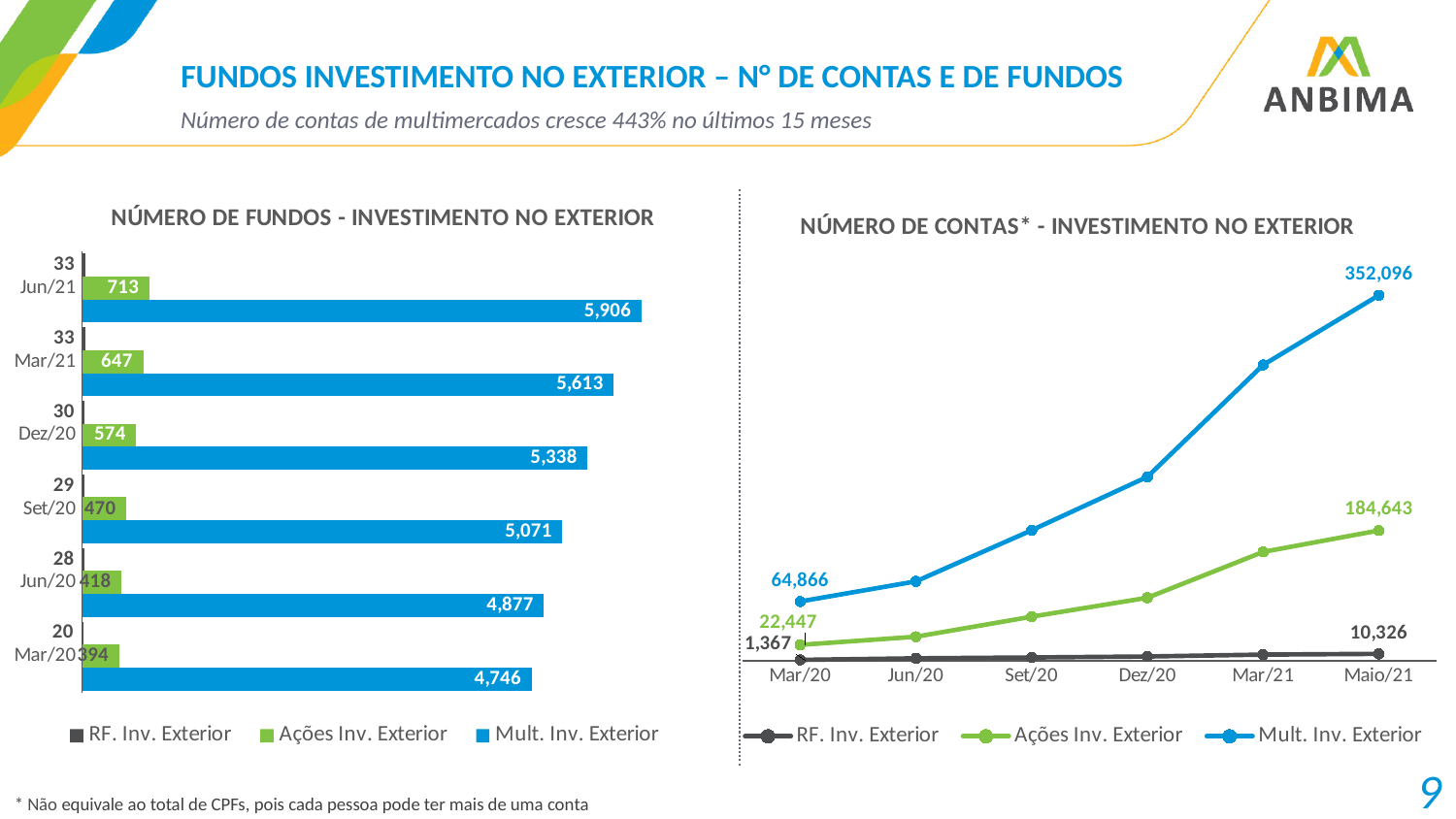
In the 'NÚMERO DE FUNDOS - INVESTIMENTO NO EXTERIOR' chart, what is the value for Ações Inv. Exterior in Dez/20? 574 In the 'NÚMERO DE FUNDOS - INVESTIMENTO NO EXTERIOR' chart, what is the value for RF. Inv. Exterior in Mar/20? 20 In the 'NÚMERO DE CONTAS* - INVESTIMENTO NO EXTERIOR' chart, what is the value for Mult. Inv. Exterior in Maio/21? 352,096 In the 'NÚMERO DE FUNDOS - INVESTIMENTO NO EXTERIOR' chart, what is the value for Mult. Inv. Exterior in Jun/21? 5,906 How many series does the legend of the 'NÚMERO DE CONTAS* - INVESTIMENTO NO EXTERIOR' chart list? 3 In the 'NÚMERO DE CONTAS* - INVESTIMENTO NO EXTERIOR' chart, does the Mult. Inv. Exterior line rise or fall from Mar/20 to Maio/21? Rise In the 'NÚMERO DE FUNDOS - INVESTIMENTO NO EXTERIOR' chart, what is the difference between the Mult. Inv. Exterior values for Jun/21 and Mar/21? 293 In the 'NÚMERO DE FUNDOS - INVESTIMENTO NO EXTERIOR' chart, which period has the lowest value for Mult. Inv. Exterior? Mar/20 In the 'NÚMERO DE FUNDOS - INVESTIMENTO NO EXTERIOR' chart, which is larger: Ações Inv. Exterior in Set/20 or in Jun/20? Set/20 In the 'NÚMERO DE CONTAS* - INVESTIMENTO NO EXTERIOR' chart, what is the value for Ações Inv. Exterior in Mar/20? 22,447 In the 'NÚMERO DE CONTAS* - INVESTIMENTO NO EXTERIOR' chart, what is the difference between the RF. Inv. Exterior values for Maio/21 and Mar/20? 8,959 What kind of chart is 'NÚMERO DE FUNDOS - INVESTIMENTO NO EXTERIOR'? Bar chart